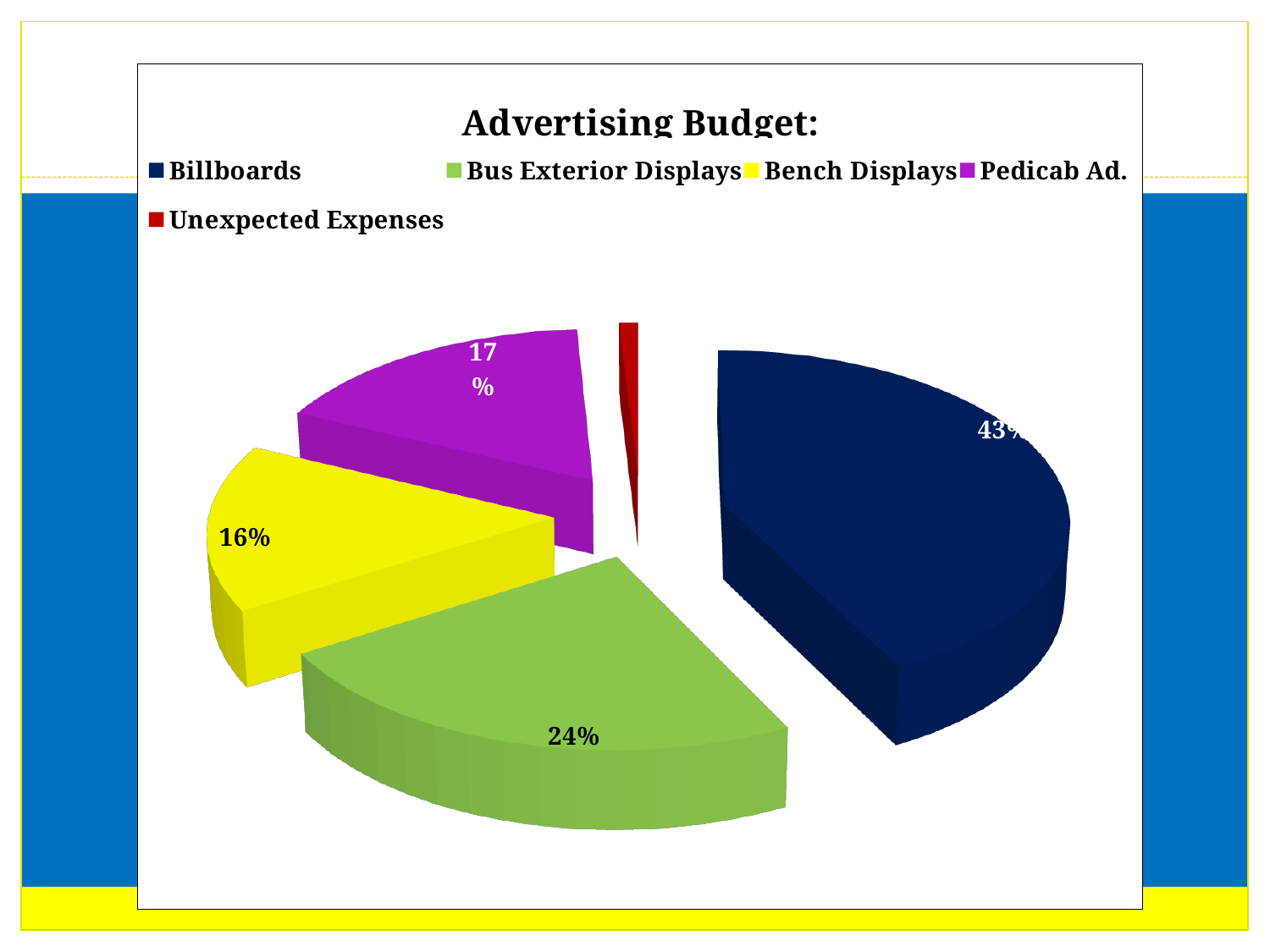
How many categories does the legend list? 5 What is the title of the chart? Advertising Budget: What share of the advertising budget goes to Bench Displays? 16% Which is larger, the share for Bus Exterior Displays or the share for Bench Displays? Bus Exterior Displays What colour is the Billboards slice? dark blue Which category has the largest slice of the pie? Billboards What share of the advertising budget goes to Pedicab Ad.? 17% By how many percentage points does the Bus Exterior Displays share exceed the Bench Displays share? 8% What share of the advertising budget goes to Billboards? 43% What share of the advertising budget goes to Bus Exterior Displays? 24% What kind of chart is shown on the slide? pie chart Which category has the smallest slice of the pie? Unexpected Expenses